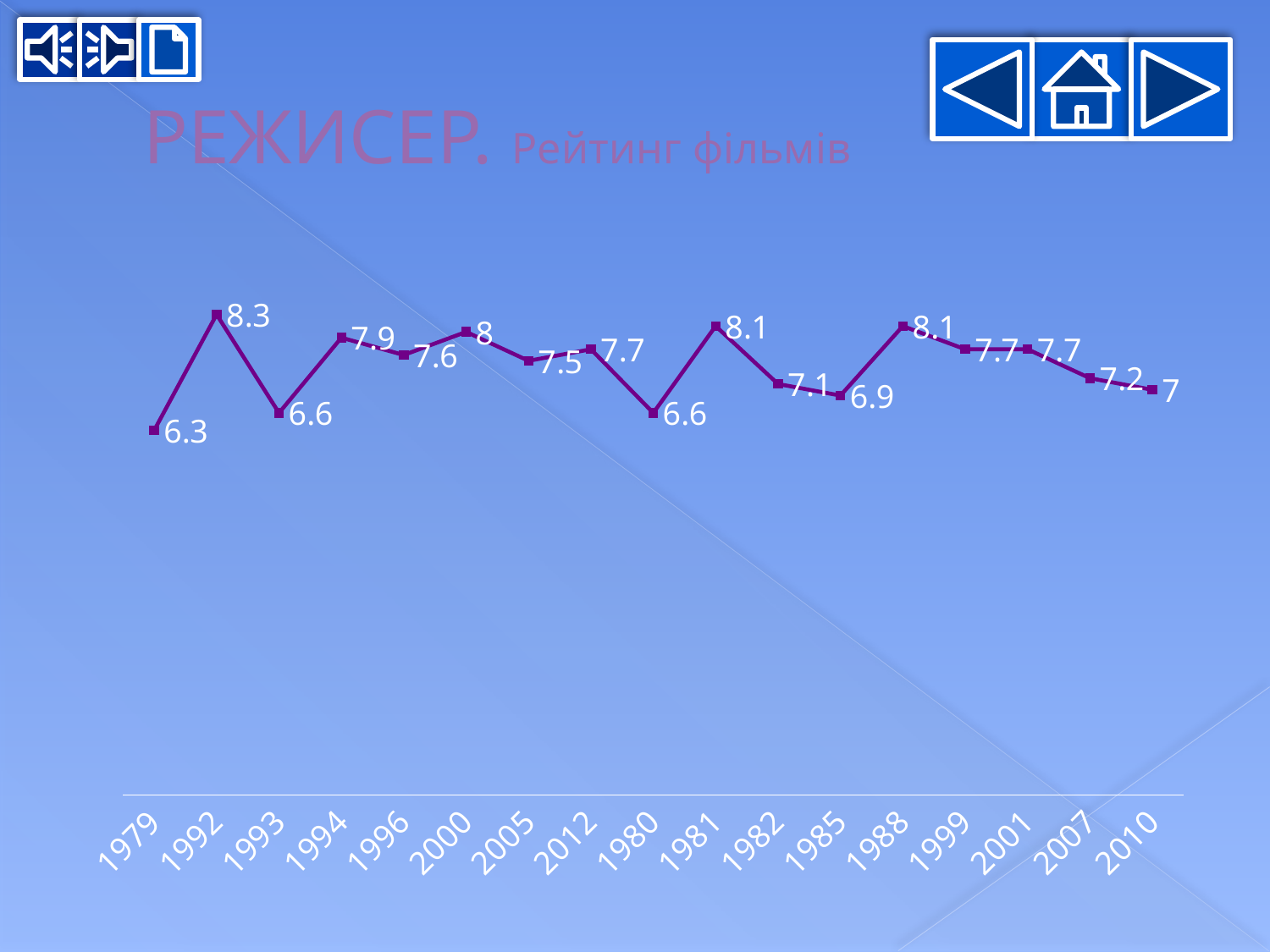
Which category has the lowest value? 1979 What is the value for 1985? 6.9 What is the title of the chart? РЕЖИСЕР. Рейтинг фільмів What is the difference between the values for 1992 and 1993? 1.7 Which is larger, the value for 1994 or the value for 1996? 1994 What is the value for 2000? 8 What is the value for 1979? 6.3 What kind of chart is shown on the slide? line chart How many data points are plotted on the chart? 17 Which category has the highest value? 1992 What is the value for 2010? 7 What is the value for 1992? 8.3